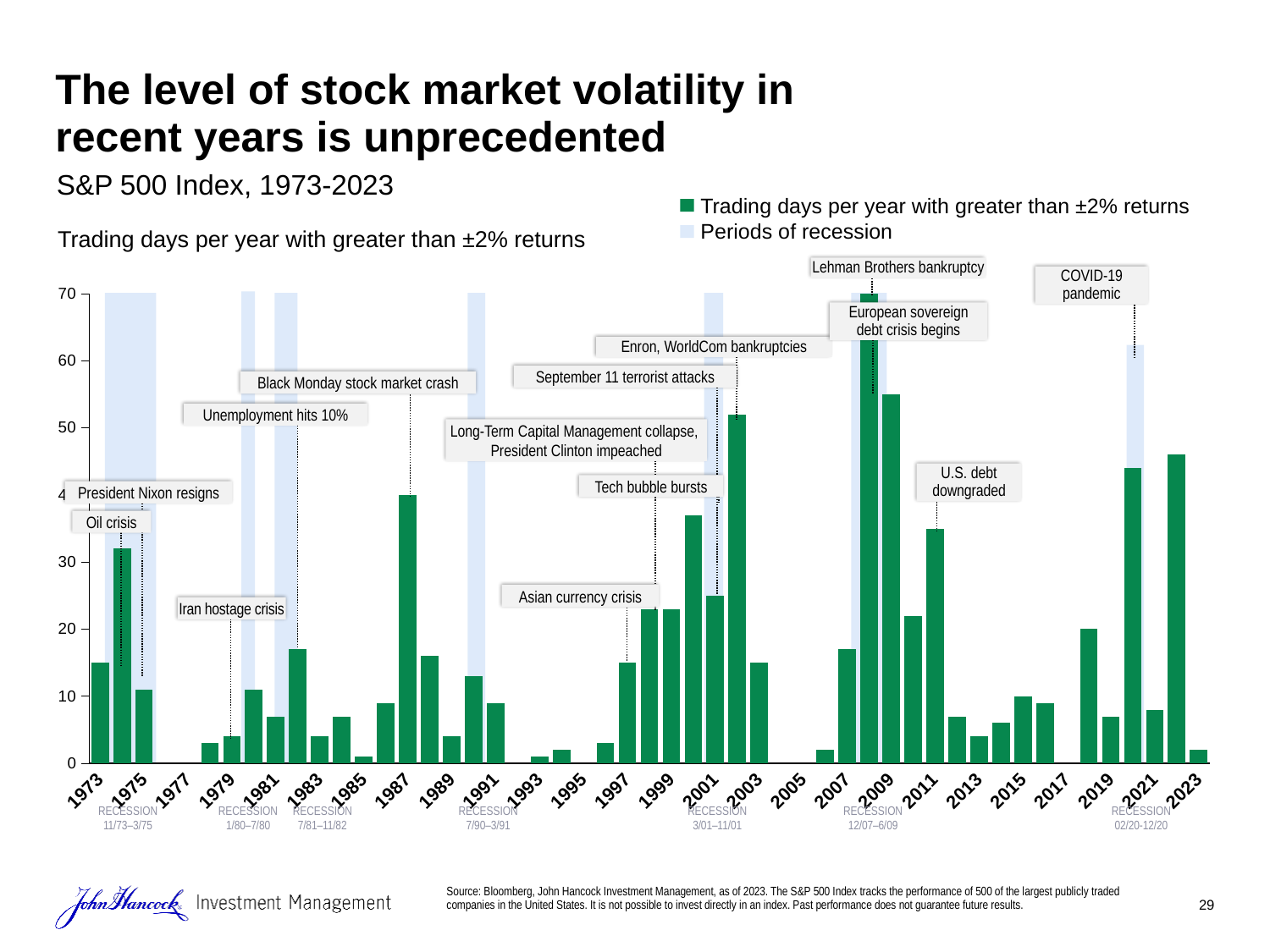
How many periods of recession are shaded on the chart? 7 Is the value for 2023 greater or less than 10? less Is the value for 2002 greater or less than 50? greater Is the value for 2018 greater or less than 30? less Which is larger, the value for 1987 or the value for 2002? 2002 Which is larger, the value for 2009 or the value for 2011? 2009 Which year has the highest number of trading days with greater than ±2% returns? 2008 What kind of chart is shown on the slide? Bar chart Which is larger, the value for 2008 or the value for 2020? 2008 How many series does the legend list? 2